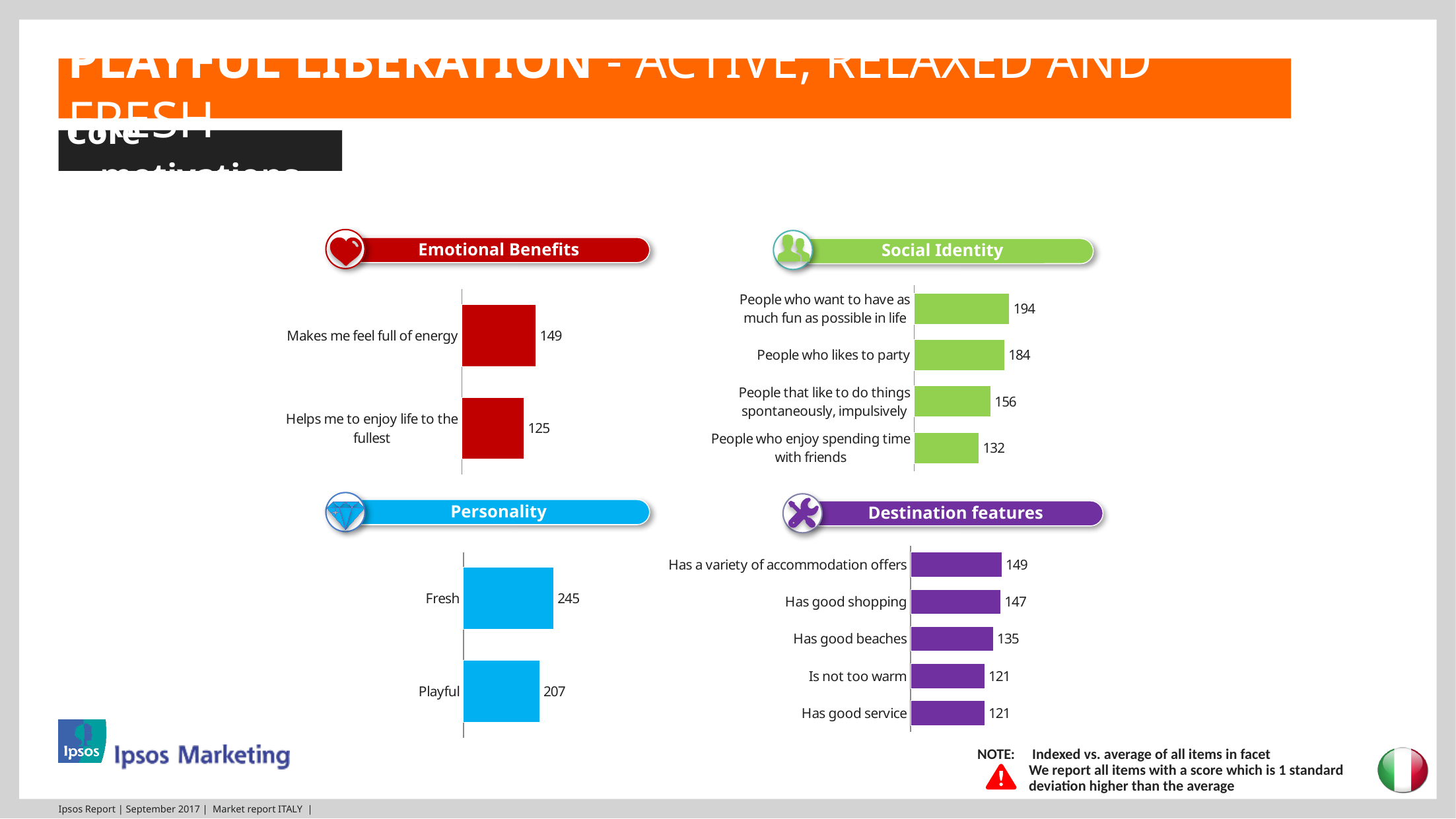
In the Personality chart, what is the value for "Fresh"? 245 In the Social Identity chart, which category has the lowest value? People who enjoy spending time with friends In the Personality chart, which is larger, Fresh or Playful? Fresh In the Emotional Benefits chart, what is the value for "Makes me feel full of energy"? 149 In the Social Identity chart, what is the value for "People who likes to party"? 184 How many categories are shown in the Destination features chart? 5 In the Social Identity chart, which category has the highest value? People who want to have as much fun as possible in life How many categories are shown in the Social Identity chart? 4 In the Emotional Benefits chart, what is the difference between "Makes me feel full of energy" and "Helps me to enjoy life to the fullest"? 24 What type of chart is the Personality chart? Bar chart In the Destination features chart, what is the difference between "Has a variety of accommodation offers" and "Has good service"? 28 In the Destination features chart, what is the value for "Has good beaches"? 135